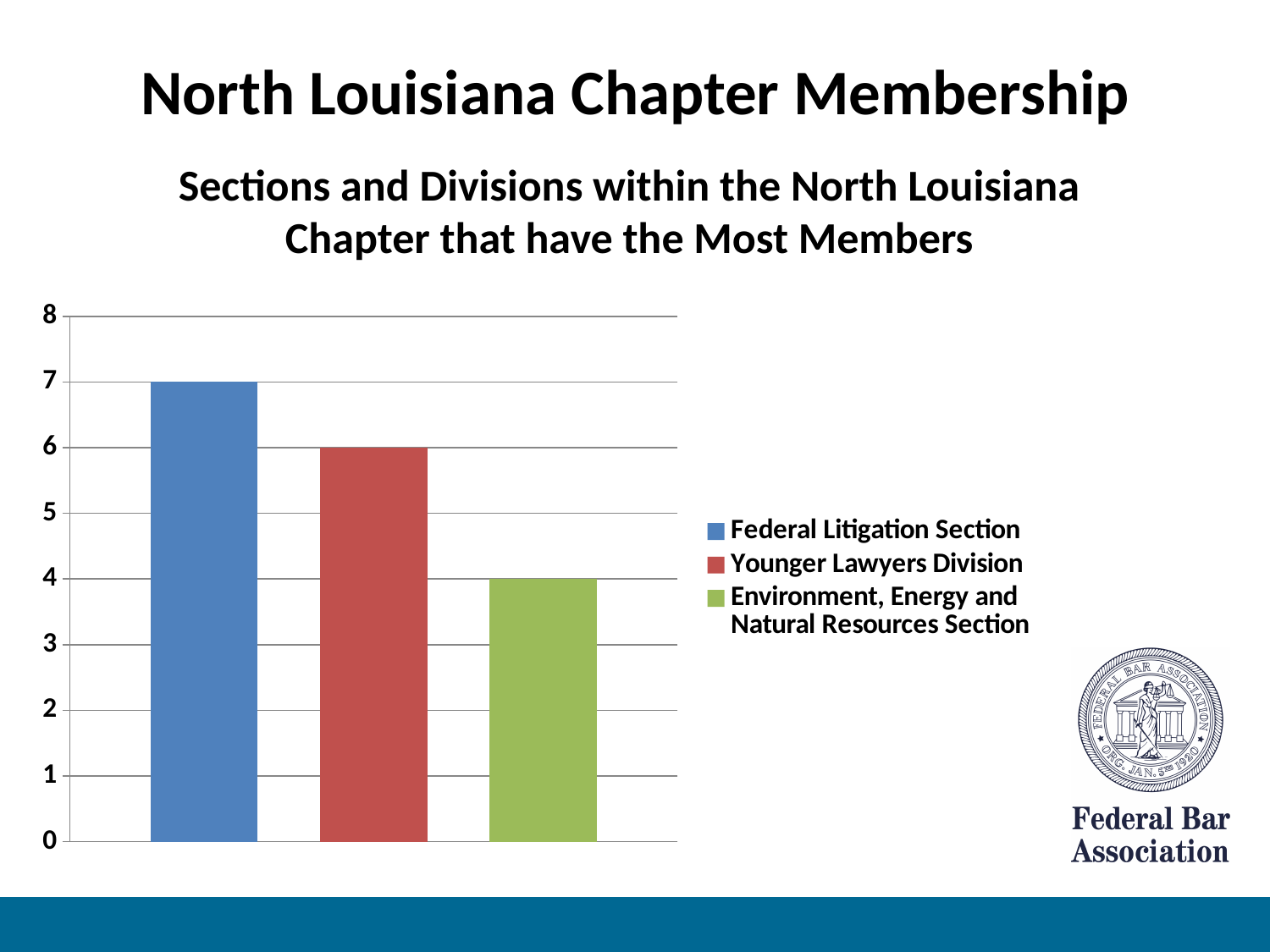
What kind of chart is shown on the slide? Bar chart How many bars are shown in the chart? 3 How many entries does the legend list? 3 What is the difference between the Federal Litigation Section and the Younger Lawyers Division? 1 What is the value for Environment, Energy and Natural Resources Section? 4 Which section or division has the fewest members? Environment, Energy and Natural Resources Section What is the value for Federal Litigation Section? 7 Is the value for Younger Lawyers Division greater or less than 5? greater What is the value for Younger Lawyers Division? 6 Which section or division has the most members? Federal Litigation Section Which is larger, the Younger Lawyers Division or the Environment, Energy and Natural Resources Section? Younger Lawyers Division What is the difference between the Federal Litigation Section and the Environment, Energy and Natural Resources Section? 3